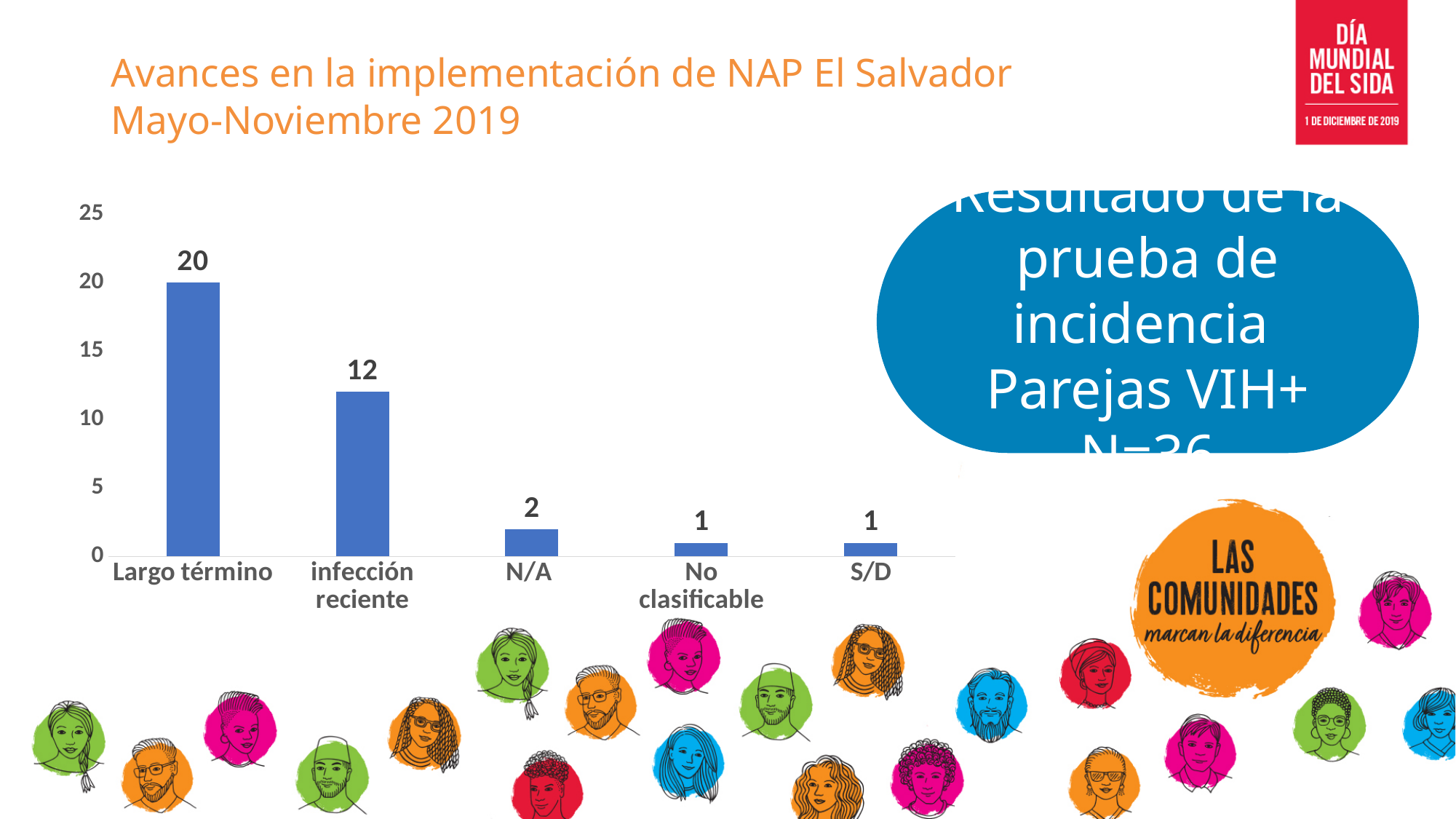
What kind of chart is shown on the slide? bar chart What is the difference between the values for Largo término and infección reciente? 8 Which category has the highest value? Largo término Which is larger, the value for infección reciente or the value for N/A? infección reciente What is the value for N/A? 2 Is the value for Largo término greater or less than 15? greater What is the value for infección reciente? 12 What is the highest value shown on the y axis? 25 What is the value for Largo término? 20 What is the value for No clasificable? 1 How many categories are shown on the x axis? 5 Do the values rise or fall from Largo término to N/A along the x axis? fall